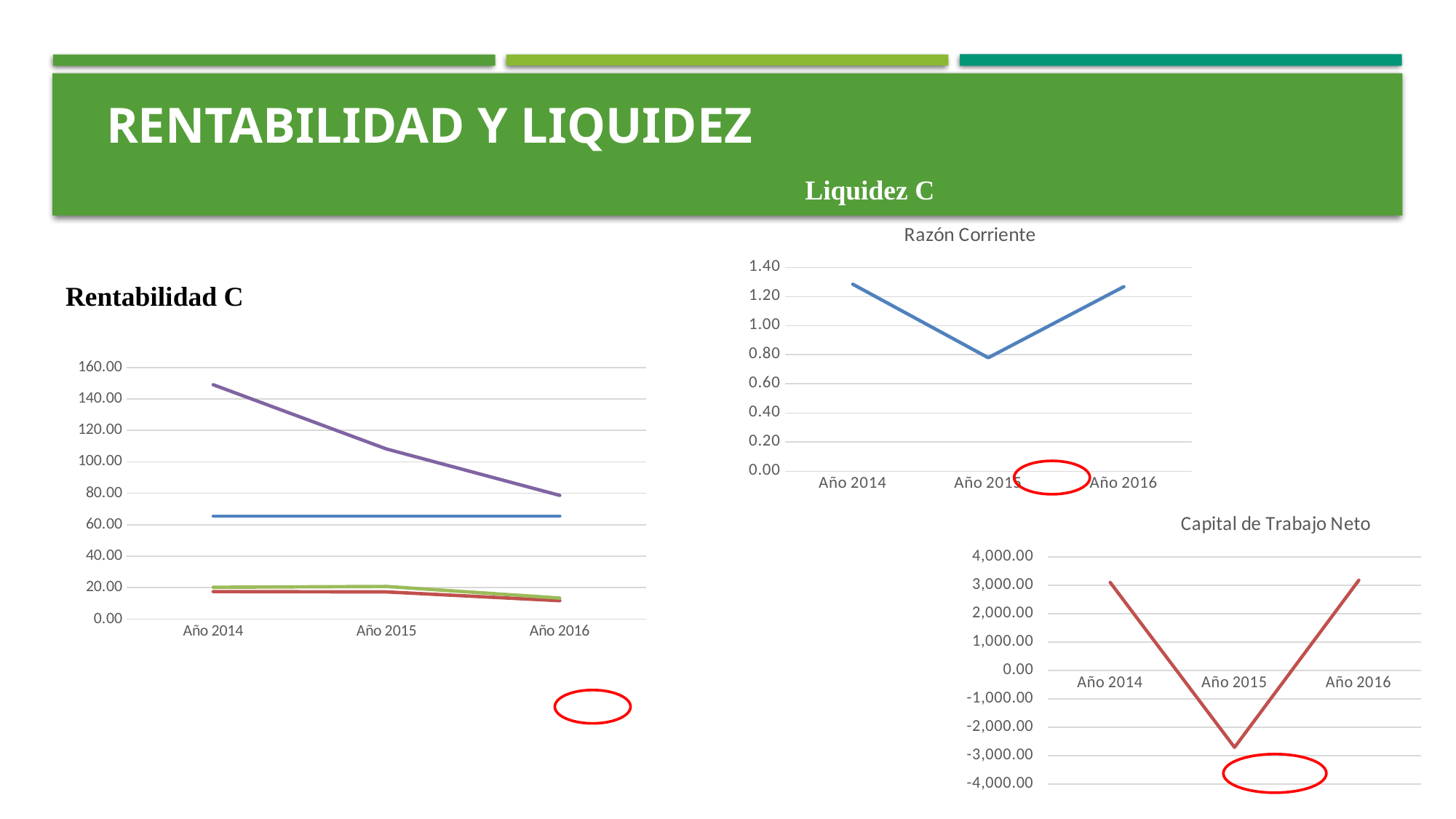
What kind of chart is the 'Capital de Trabajo Neto' chart? line chart In the 'Rentabilidad C' chart, is the value of the purple line for Año 2014 greater or less than 140.00? greater In the 'Razón Corriente' chart, is the value for Año 2014 greater or less than 1.00? greater In the 'Razón Corriente' chart, which year has the lowest value? Año 2015 In the 'Capital de Trabajo Neto' chart, is the value for Año 2016 greater or less than 2,000.00? greater In the 'Rentabilidad C' chart, does the purple line rise or fall from Año 2014 to Año 2016? fall What kind of chart is the 'Razón Corriente' chart? line chart How many years are plotted on the x axis of the 'Razón Corriente' chart? 3 In the 'Capital de Trabajo Neto' chart, which year has the lowest value? Año 2015 In the 'Capital de Trabajo Neto' chart, which is larger, the value for Año 2014 or the value for Año 2015? Año 2014